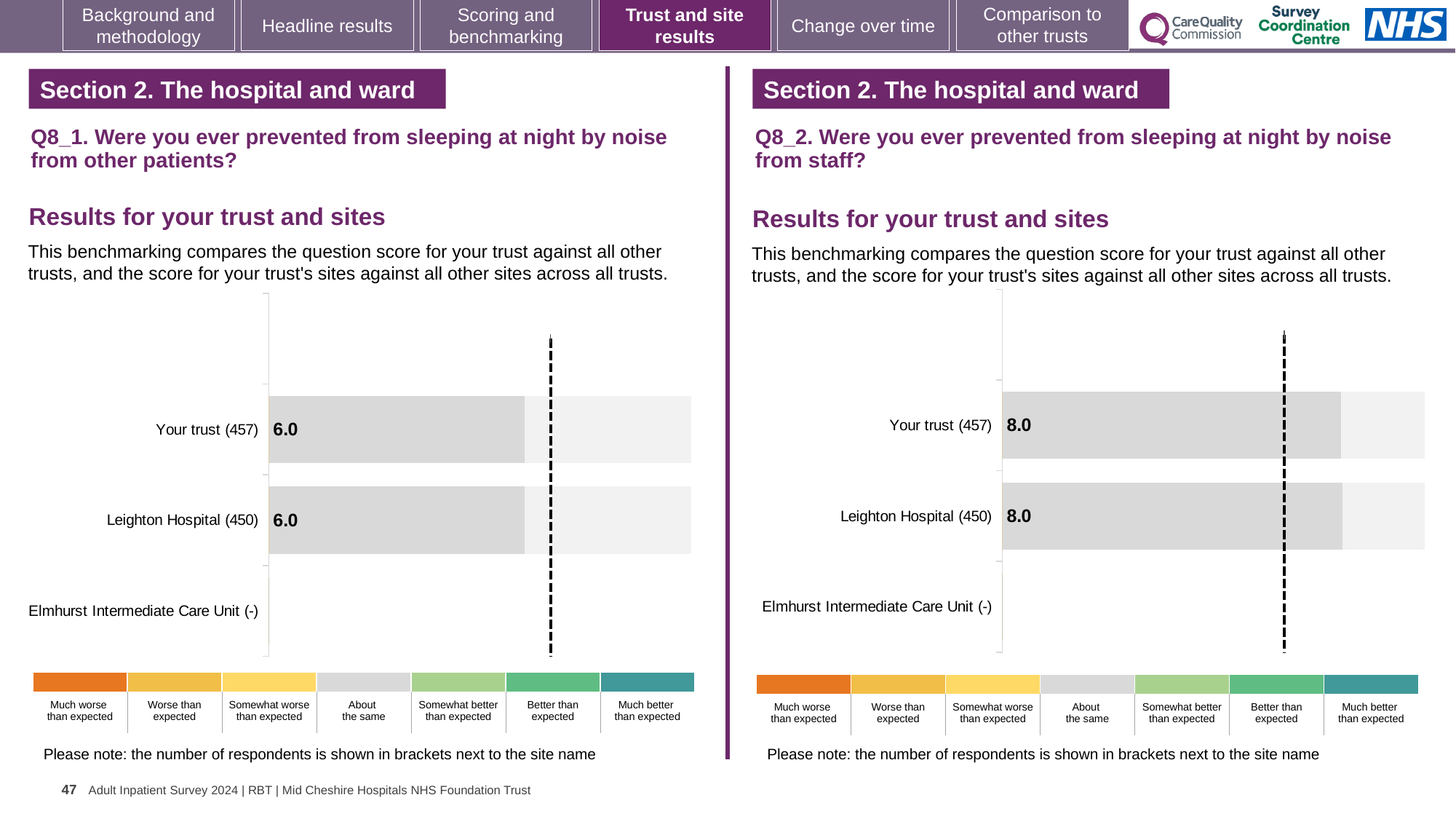
In the Q8_1 chart (left), what is the score for Leighton Hospital (450)? 6.0 In the Q8_2 chart (right), how many respondents are shown in brackets for Leighton Hospital? 450 In the Q8_1 chart (left), what is the score for Your trust (457)? 6.0 What is the difference between the Leighton Hospital score in the Q8_2 chart (right) and the Leighton Hospital score in the Q8_1 chart (left)? 2.0 What kind of chart is used in the Q8_1 chart (left)? Bar chart In the Q8_1 chart (left), how many site/trust categories are listed on the vertical axis? 3 In the Q8_1 chart (left), is the score for Your trust (457) greater or less than the score for Leighton Hospital (450), or are they equal? Equal In the Q8_2 chart (right), what is the score for Leighton Hospital (450)? 8.0 In the Q8_2 chart (right), how many site/trust categories are listed on the vertical axis? 3 In the Q8_1 chart (left), which category has no bar plotted? Elmhurst Intermediate Care Unit (-) In the Q8_2 chart (right), what is the score for Your trust (457)? 8.0 Which is larger: the Your trust score in the Q8_1 chart (left) or the Your trust score in the Q8_2 chart (right)? Q8_2 (right)